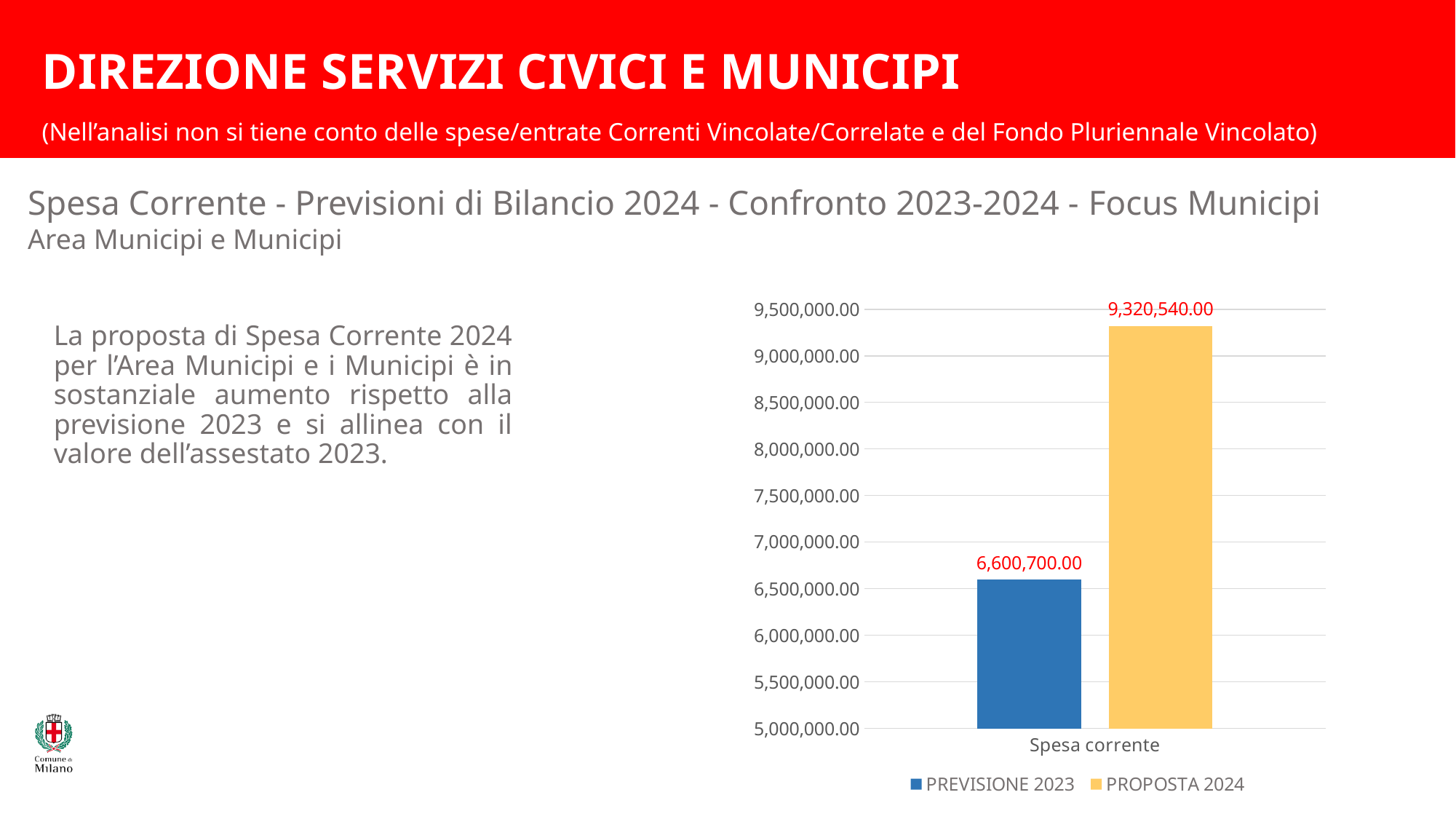
Which series has the higher value for Spesa corrente, PREVISIONE 2023 or PROPOSTA 2024? PROPOSTA 2024 Which series shows the lowest value in the chart? PREVISIONE 2023 What is the value of PREVISIONE 2023 for Spesa corrente? 6,600,700.00 Is the value for PREVISIONE 2023 greater or less than 7,000,000.00? less What kind of chart is shown on the slide? Bar chart What is the value of PROPOSTA 2024 for Spesa corrente? 9,320,540.00 What is the difference between the PROPOSTA 2024 value and the PREVISIONE 2023 value for Spesa corrente? 2,719,840.00 What colour is the bar for PROPOSTA 2024? Yellow How many series does the legend list? 2 How many categories are shown on the x axis of the chart? 1 Which series shows the highest value in the chart? PROPOSTA 2024 Is the value for PROPOSTA 2024 greater or less than 9,000,000.00? greater